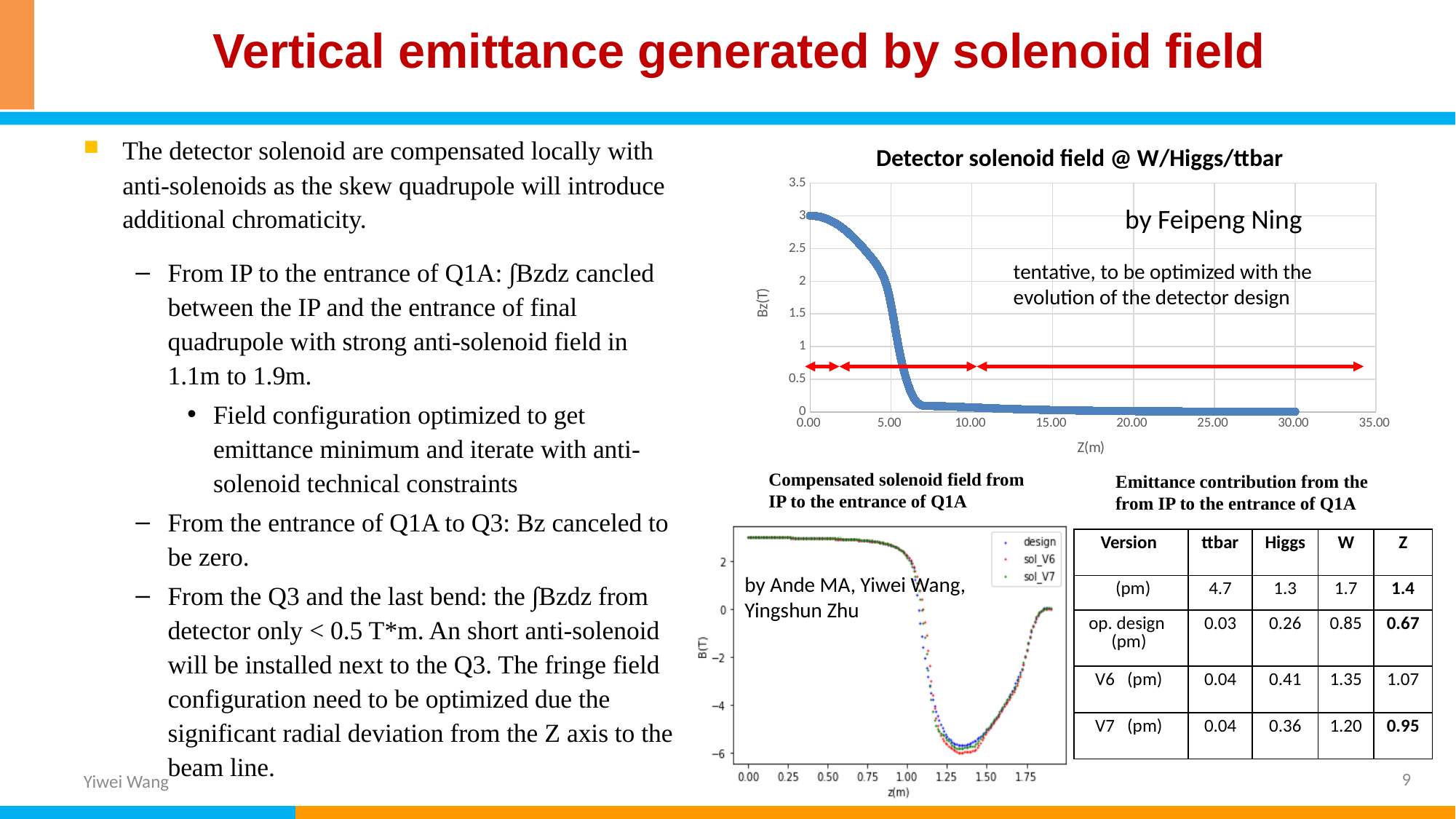
In the 'Detector solenoid field @ W/Higgs/ttbar' chart, is the value of Bz at Z = 5.00 greater or less than 1? greater What kind of chart is the 'Compensated solenoid field from IP to the entrance of Q1A' chart? scatter chart In the 'Detector solenoid field @ W/Higgs/ttbar' chart, is the value of Bz at Z = 10.00 greater or less than 0.5? less In the 'Detector solenoid field @ W/Higgs/ttbar' chart, does Bz rise or fall as Z increases? fall What is the highest tick value shown on the x axis of the 'Detector solenoid field @ W/Higgs/ttbar' chart? 35.00 In the 'Compensated solenoid field from IP to the entrance of Q1A' chart, is the minimum value of B greater or less than -4? less What is the title of the chart at the top right of the slide? Detector solenoid field @ W/Higgs/ttbar What are the legend entries in the 'Compensated solenoid field from IP to the entrance of Q1A' chart? design, sol_V6, sol_V7 How many series does the legend of the 'Compensated solenoid field from IP to the entrance of Q1A' chart list? 3